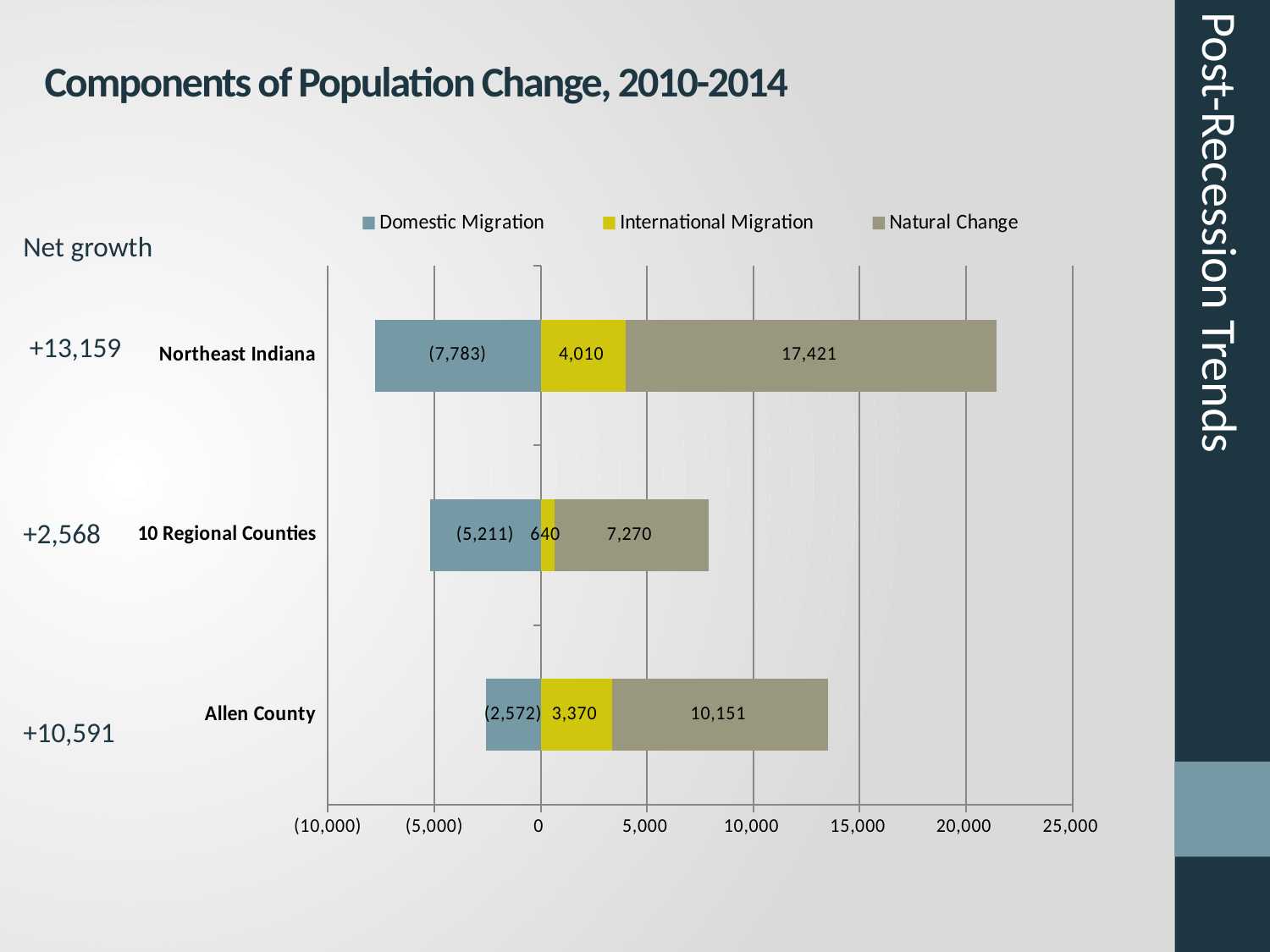
How many series does the legend list? 3 What kind of chart is shown on the slide? Stacked bar chart What is the Natural Change value for Northeast Indiana? 17,421 Which category has the highest Natural Change value? Northeast Indiana What is the International Migration value for Allen County? 3,370 What is the International Migration value for 10 Regional Counties? 640 What is the difference between the Natural Change values for Northeast Indiana and Allen County? 7,270 Which category has the lowest International Migration value? 10 Regional Counties How many categories are shown on the chart? 3 What net growth figure is shown for Allen County? +10,591 Which is larger, the International Migration value for Northeast Indiana or for Allen County? Northeast Indiana What is the Domestic Migration value for 10 Regional Counties? (5,211)